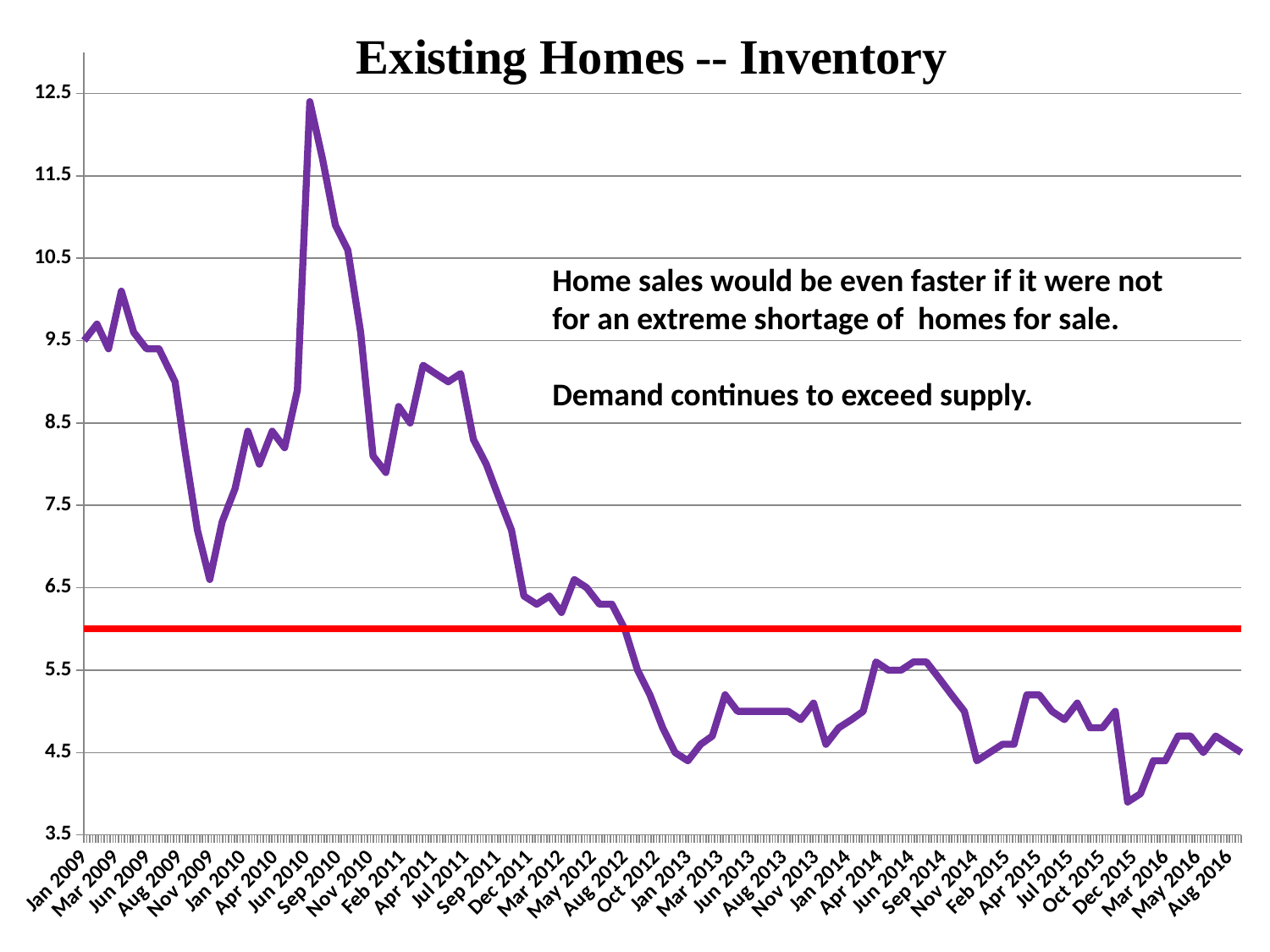
Is the value for Dec 2015 greater or less than 4.5? less In which year does the line reach its lowest point? 2015 What kind of chart is shown on the slide? line chart Which is larger, the value for Jan 2009 or the value for Aug 2016? Jan 2009 What is the title of the chart? Existing Homes -- Inventory Is the value for Jan 2013 greater or less than 5.5? less Is the value for Jan 2009 greater or less than 8.5? greater Overall, does the line rise or fall from Jan 2009 to Aug 2016? fall In which year does the line reach its highest point? 2010 What colour is the plotted data line? purple